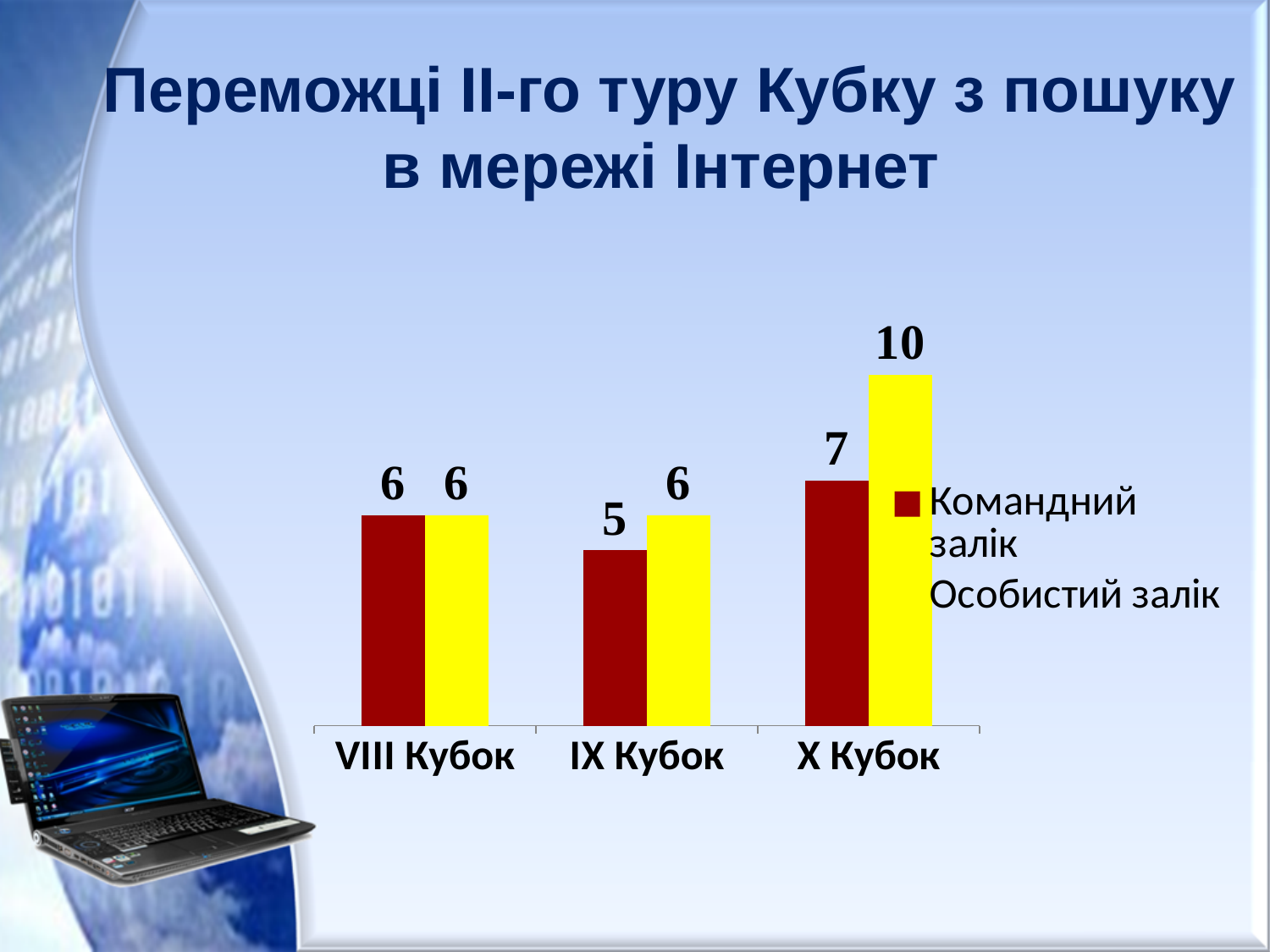
What is the difference between Особистий залік and Командний залік for X Кубок? 3 Which category has the lowest value for Командний залік? IX Кубок What is the value of Особистий залік for IX Кубок? 6 What is the value of Особистий залік for X Кубок? 10 How many categories are shown on the x axis? 3 What is the value of Командний залік for VIII Кубок? 6 What is the value of Командний залік for IX Кубок? 5 Which is larger for IX Кубок: Командний залік or Особистий залік? Особистий залік Which category has the highest value for Особистий залік? X Кубок How many series does the legend list? 2 Which colour represents Командний залік in the chart? Dark red What kind of chart is shown on the slide? Bar chart